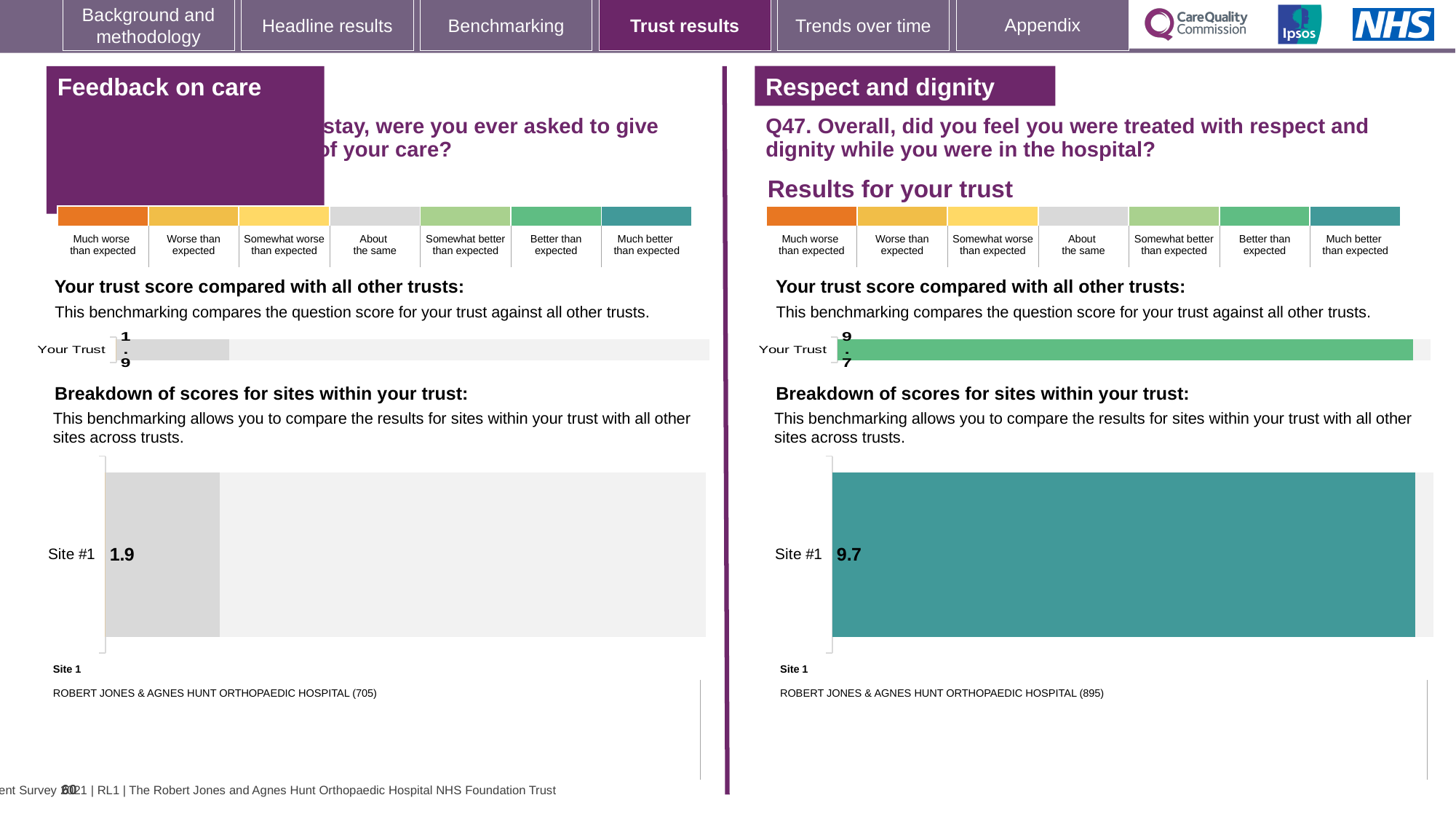
What colour is the Site #1 bar in the 'Respect and dignity' breakdown chart? Teal How many sites are shown in the 'Breakdown of scores for sites within your trust' chart on the 'Respect and dignity' section? 1 What kind of chart is used to show the Site #1 score in the 'Feedback on care' breakdown section? Bar chart How many sites are shown in the 'Breakdown of scores for sites within your trust' chart on the 'Feedback on care' section? 1 On the 'Feedback on care' section, what is the score shown for Your Trust in the 'Your trust score compared with all other trusts' chart? 1.9 On the 'Feedback on care' section, what is the score for Site #1 in the 'Breakdown of scores for sites within your trust' chart? 1.9 What is the name of the site listed as Site 1 below the 'Respect and dignity' breakdown chart? ROBERT JONES & AGNES HUNT ORTHOPAEDIC HOSPITAL (895) On the 'Respect and dignity' section, what is the score for Site #1 in the 'Breakdown of scores for sites within your trust' chart? 9.7 What is the difference between the Your Trust score in the 'Respect and dignity' chart and the Your Trust score in the 'Feedback on care' chart? 7.8 On the 'Respect and dignity' section, what is the score shown for Your Trust in the 'Your trust score compared with all other trusts' chart? 9.7 Which is larger: the Site #1 score in the 'Respect and dignity' breakdown chart or the Site #1 score in the 'Feedback on care' breakdown chart? Respect and dignity